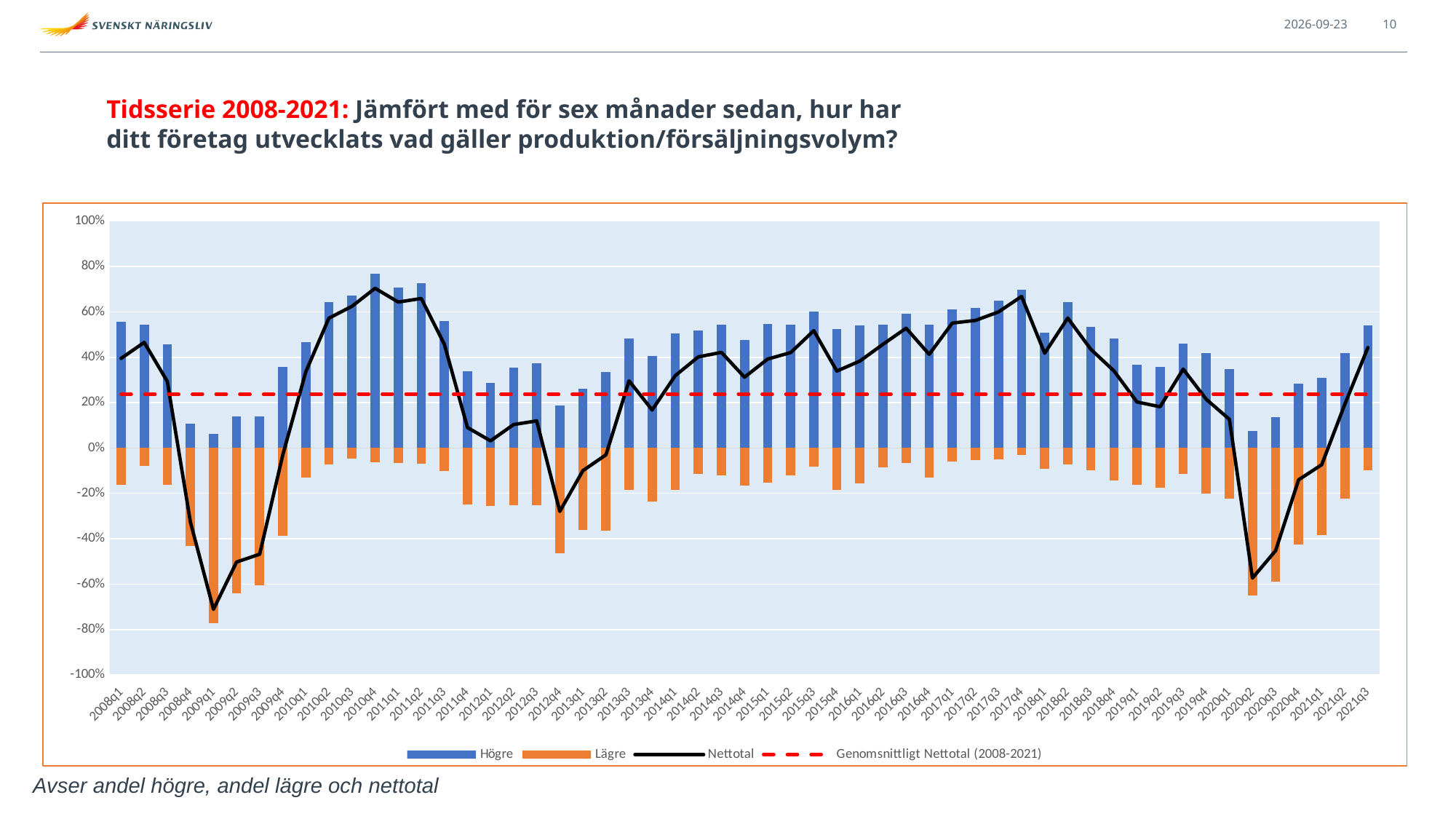
What does the red dashed line represent according to the legend? Genomsnittligt Nettotal (2008-2021) Which quarter has the most negative value for Lägre? 2009q1 Is the Högre value for 2009q1 greater or less than 20%? less How many quarters are shown on the x axis? 55 What kind of chart is shown on the slide? Bar chart with line series Is the Nettotal value for 2012q4 greater or less than -20%? less Which quarter has the highest value for Högre? 2010q4 Does the Nettotal line rise or fall from 2020q2 to 2021q3? rise Which quarter has the lowest Nettotal value? 2009q1 How many series does the legend list? 4 Which quarter has the larger Högre value, 2008q1 or 2009q1? 2008q1 Is the Högre value for 2010q4 greater or less than 60%? greater